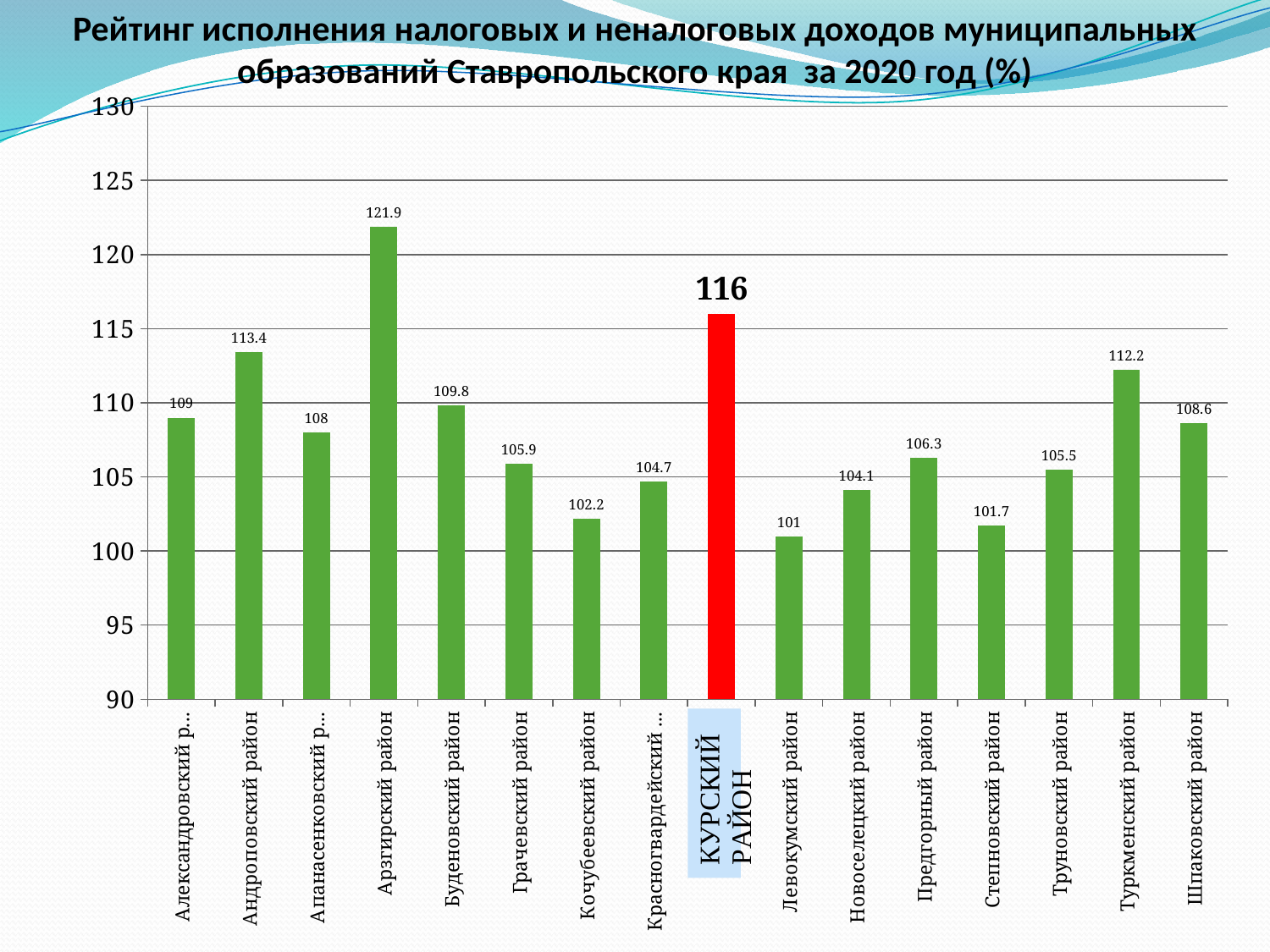
What is the value for Туркменский район? 112.2 What is the difference between the values for Арзгирский район and КУРСКИЙ РАЙОН? 5.9 Which is larger, the value for Андроповский район or the value for Буденновский район? Андроповский район What kind of chart is shown on the slide? bar chart What is the value for Левокумский район? 101 Which bar is coloured red instead of green? КУРСКИЙ РАЙОН Which district has the lowest value? Левокумский район Which district has the highest value? Арзгирский район What is the value for Арзгирский район? 121.9 What is the value for КУРСКИЙ РАЙОН? 116 How many districts are shown on the chart? 16 Is the value for Предгорный район greater or less than 105? greater